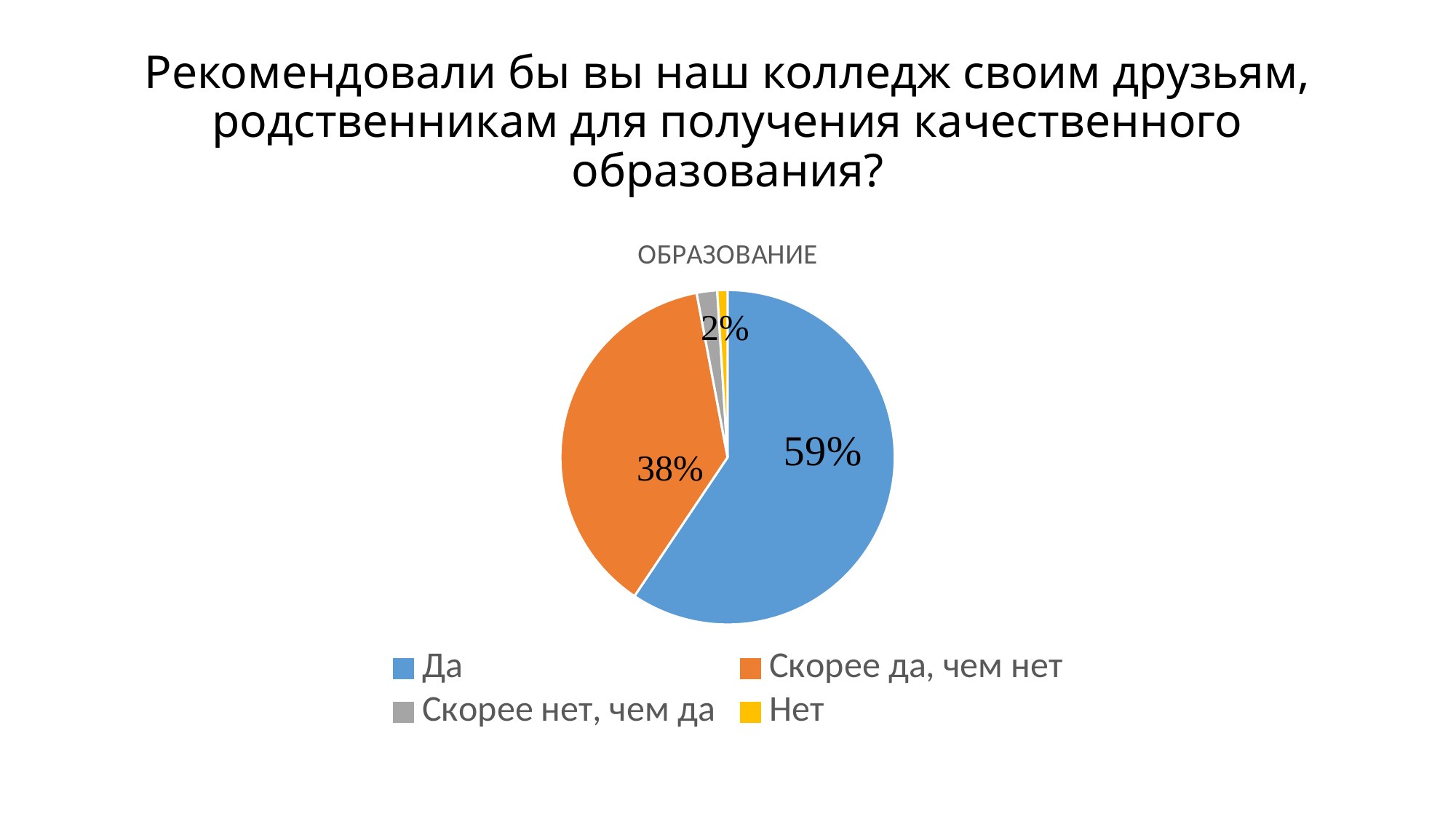
What is the title of the chart? ОБРАЗОВАНИЕ How many entries does the legend list? 4 By how many percentage points does the "Да" slice exceed the "Скорее да, чем нет" slice? 21 percentage points Which category has the smallest slice of the pie? Нет What share of the pie does the "Скорее да, чем нет" slice represent? 38% Which category has the largest slice of the pie? Да What share of the pie does the "Скорее нет, чем да" slice represent? 2% How many categories are shown in the pie chart? 4 What kind of chart is shown on the slide? Pie chart What colour is the "Да" slice in the pie chart? Blue What share of the pie does the "Да" slice represent? 59% Which is larger: the "Скорее да, чем нет" slice or the "Скорее нет, чем да" slice? Скорее да, чем нет